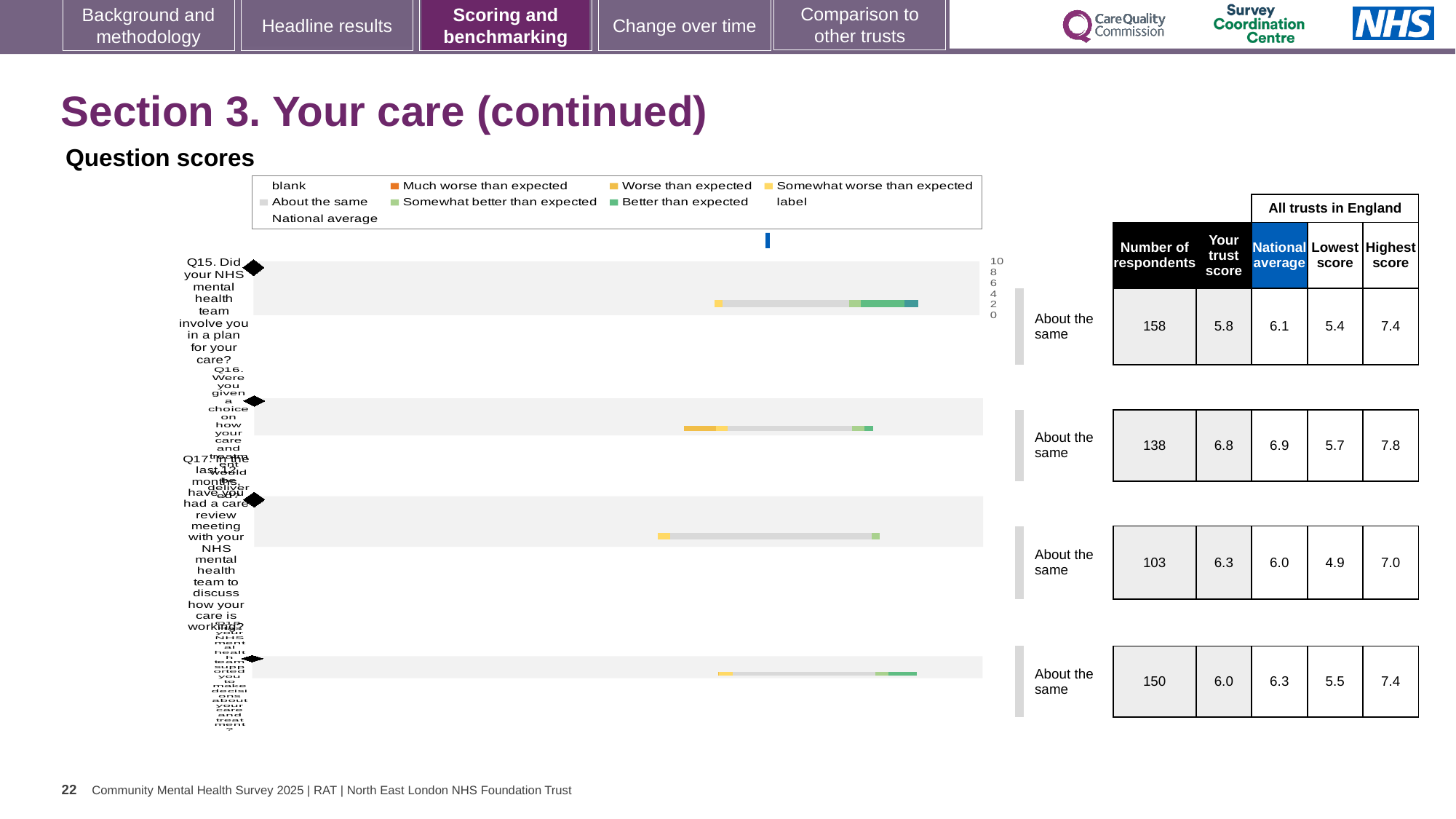
What benchmark category is shown for Q15? About the same What is the lowest score across all trusts in England for Q17? 4.9 What kind of chart is used to show the question scores on this slide? bar chart For Q17, is the trust score or the national average higher? trust score What is the trust score for Q16 (Were you given a choice on how your care and treatment would be delivered)? 6.8 What is the highest score across all trusts in England for Q16? 7.8 What is the difference between the highest score and the lowest score for Q15? 2.0 What is the national average for Q17 (In the last 12 months, have you had a care review meeting)? 6.0 Which question has the fewest respondents? Q17 What is the number of respondents for Q15 (Did your NHS mental health team involve you in a plan for your care?)? 158 How many question bars are plotted in the question scores chart? 4 Which question has the highest trust score? Q16